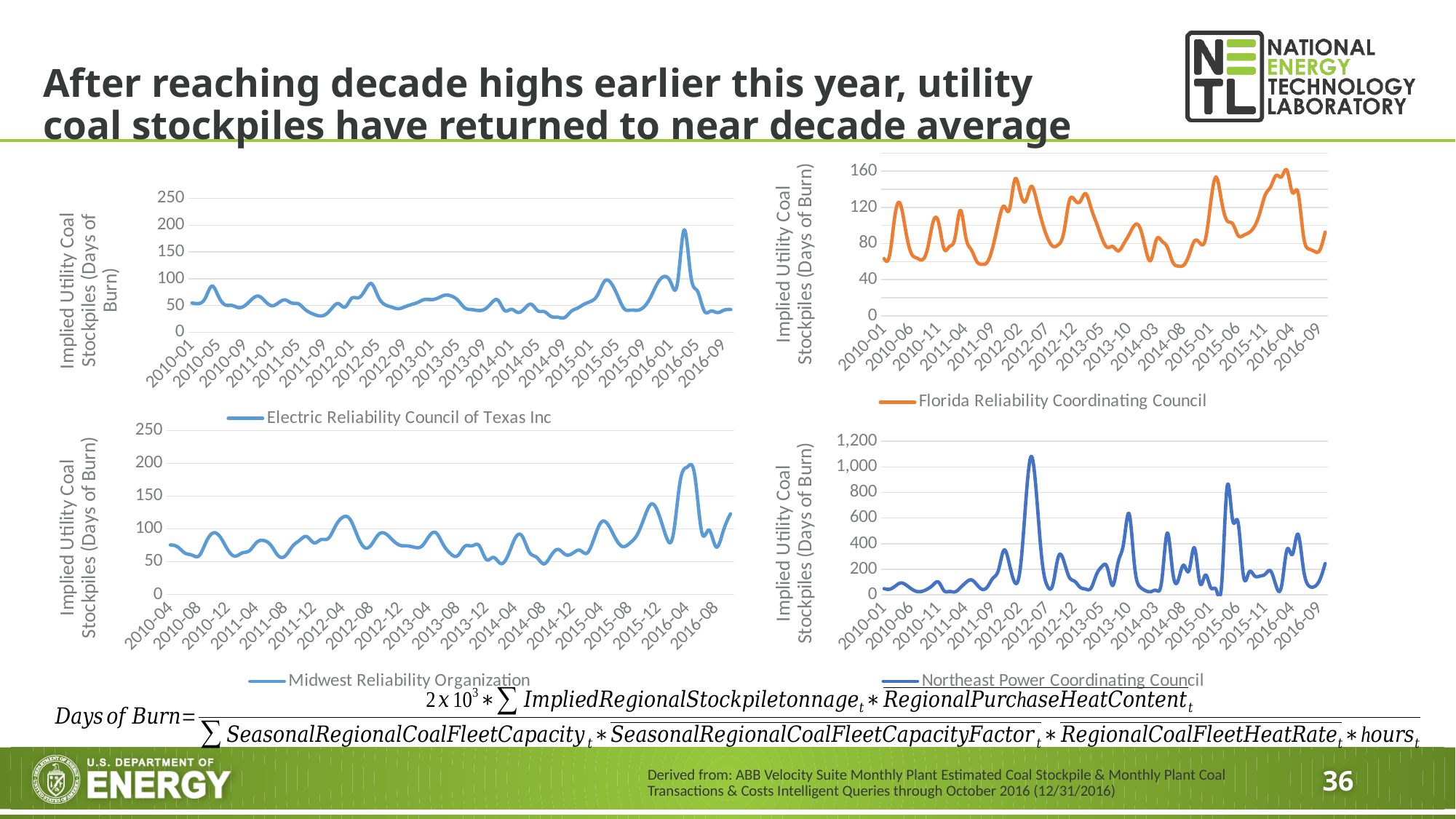
What kind of chart is the top-left chart labelled Electric Reliability Council of Texas Inc? Line chart In the Northeast Power Coordinating Council chart, is the value at 2010-01 greater or less than 200? less How many series does the legend of the top-right chart list? 1 In the Midwest Reliability Organization chart, is the peak value around 2016-04 greater or less than 150? greater In the Florida Reliability Coordinating Council chart, is the value at 2010-01 greater or less than 80? less Which series is plotted in the top-right chart, according to its legend? Florida Reliability Coordinating Council Which series is plotted in the bottom-right chart, according to its legend? Northeast Power Coordinating Council What is the maximum value shown on the y axis of the Northeast Power Coordinating Council chart? 1,200 How many charts are shown on the slide? 4